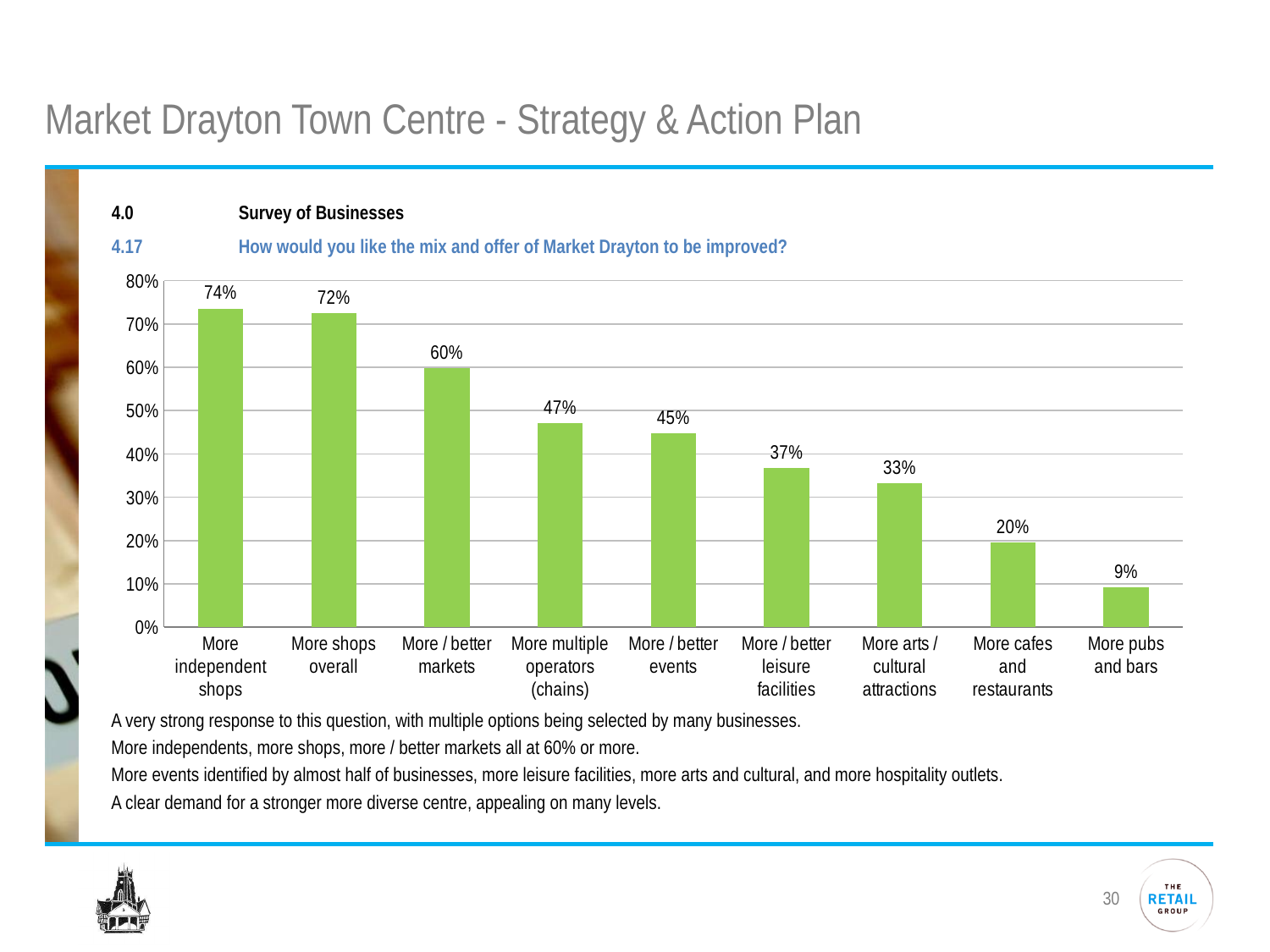
Which category has the lowest value? More pubs and bars What percentage of businesses selected 'More independent shops'? 74% What is the value for 'More / better markets'? 60% How many categories are shown in the chart? 9 What is the maximum value shown on the vertical axis? 80% Do the values rise or fall from left to right across the categories? Fall Which category has the highest value? More independent shops What percentage is shown for 'More cafes and restaurants'? 20% What type of chart is shown? Bar chart Which is larger: 'More / better events' or 'More / better leisure facilities'? More / better events What is the difference between 'More shops overall' and 'More multiple operators (chains)'? 25% Is the value for 'More arts / cultural attractions' greater or less than 40%? less